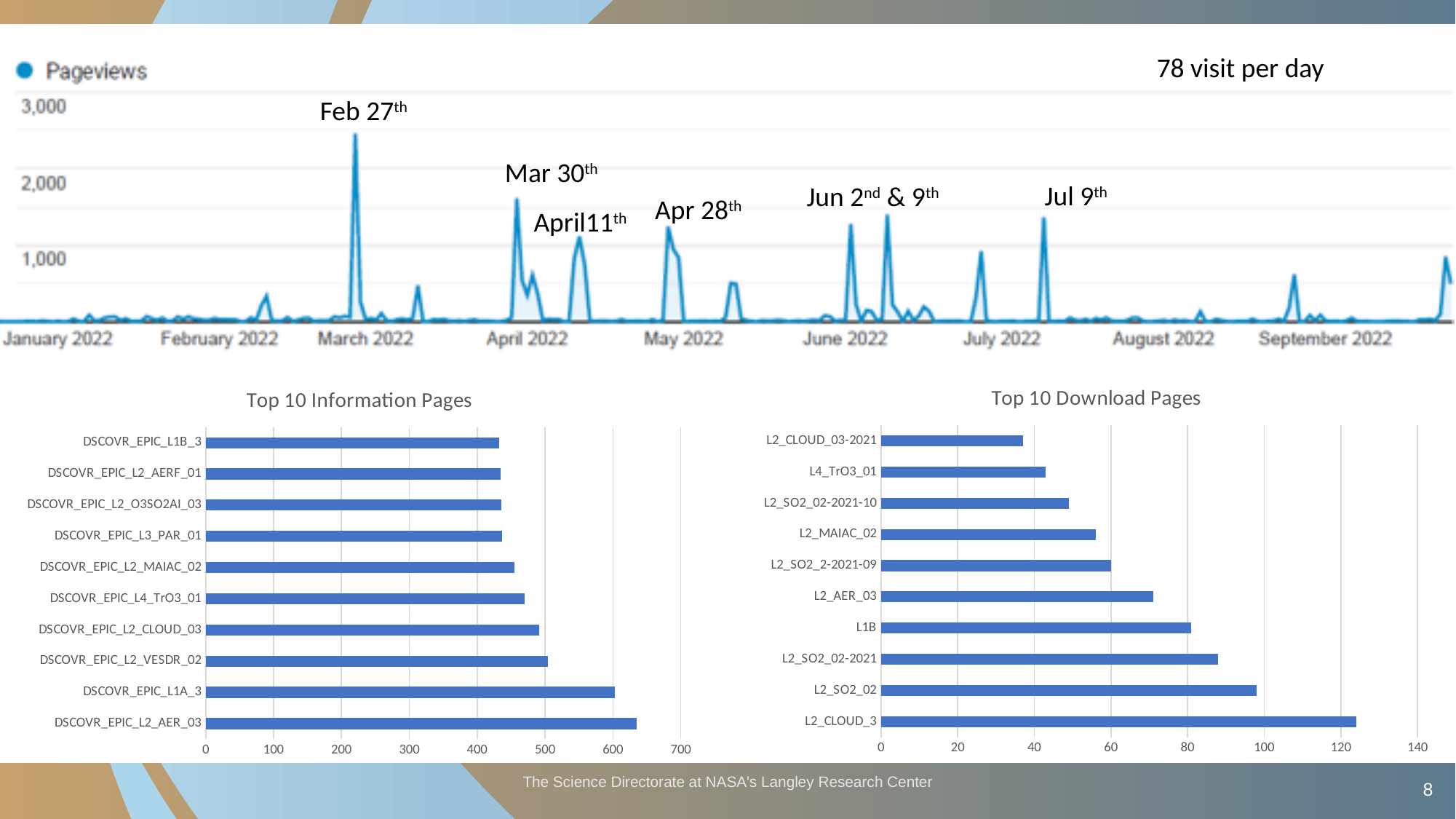
How many pages are listed in the Top 10 Download Pages chart? 10 In the Top 10 Download Pages chart, is the value for L2_AER_03 greater or less than 60? greater In the Top 10 Information Pages chart, which is larger, the value for DSCOVR_EPIC_L1A_3 or the value for DSCOVR_EPIC_L2_MAIAC_02? DSCOVR_EPIC_L1A_3 In the Top 10 Information Pages chart, is the value for DSCOVR_EPIC_L4_TrO3_01 greater or less than 500? less What kind of chart is the Top 10 Information Pages chart? bar chart In the Top 10 Download Pages chart, which is larger, the value for L2_SO2_02 or the value for L2_MAIAC_02? L2_SO2_02 In the Top 10 Download Pages chart, is the value for L2_CLOUD_3 greater or less than 100? greater In the Top 10 Information Pages chart, which page has the highest value? DSCOVR_EPIC_L2_AER_03 In the Top 10 Download Pages chart, which page has the highest value? L2_CLOUD_3 In the Top 10 Download Pages chart, which page has the lowest value? L2_CLOUD_03-2021